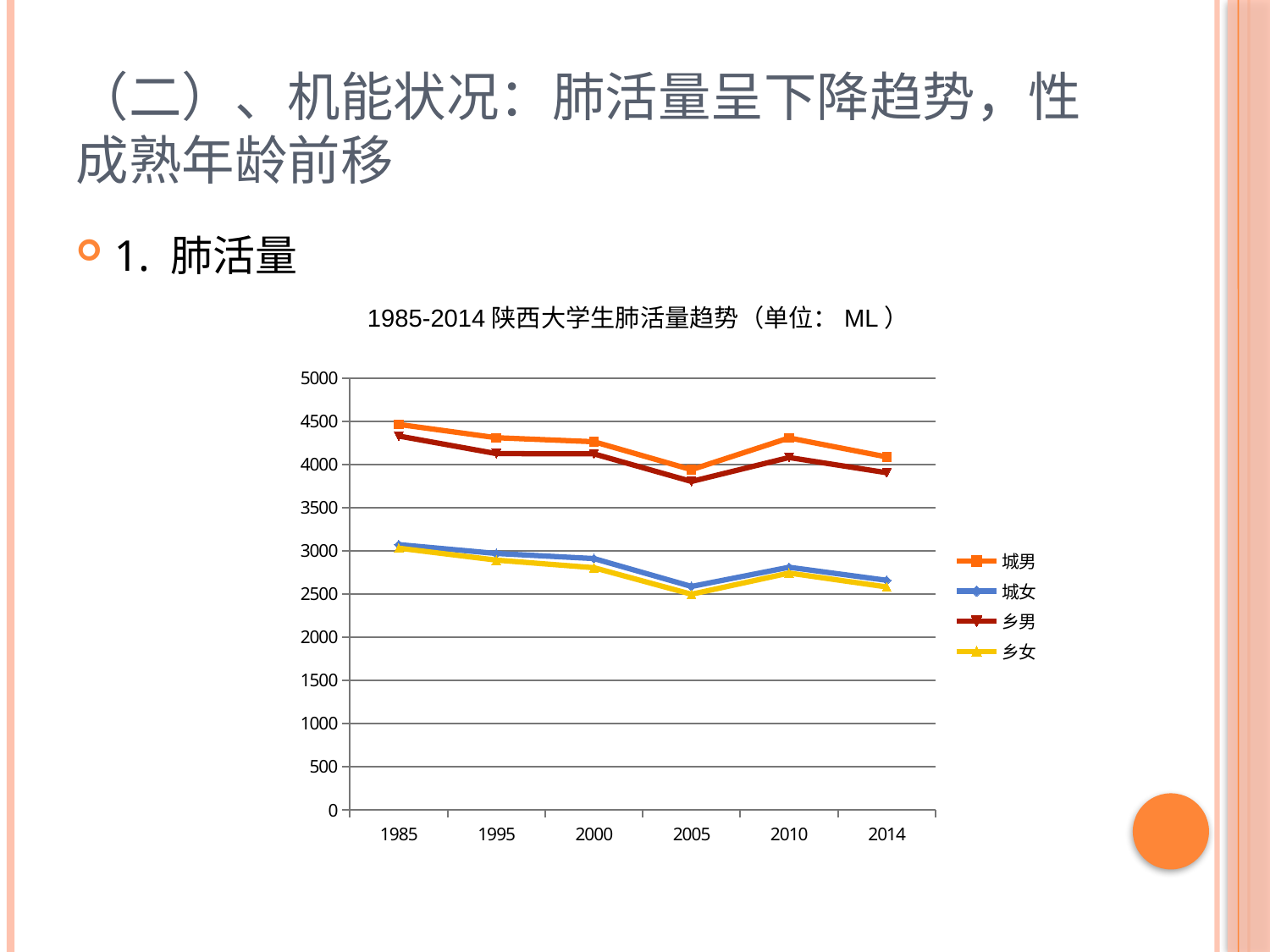
How many series does the legend list? 4 What is the title of the chart? 1985-2014 陕西大学生肺活量趋势（单位： ML ） Is the value for 乡男 in 2005 greater or less than 4000? less In which year does the 城男 series reach its lowest value? 2005 Which series has the highest value in 1985? 城男 Which series has the lowest value in 2005? 乡女 Is the value for 城女 in 2014 greater or less than 2500? greater Which is larger in 2005, the value for 城男 or the value for 乡男? 城男 How many years are shown on the x axis? 6 What kind of chart is shown on the slide? line chart Is the value for 城男 in 1985 greater or less than 4000? greater Overall, do the values for 乡女 rise or fall from 1985 to 2014? fall